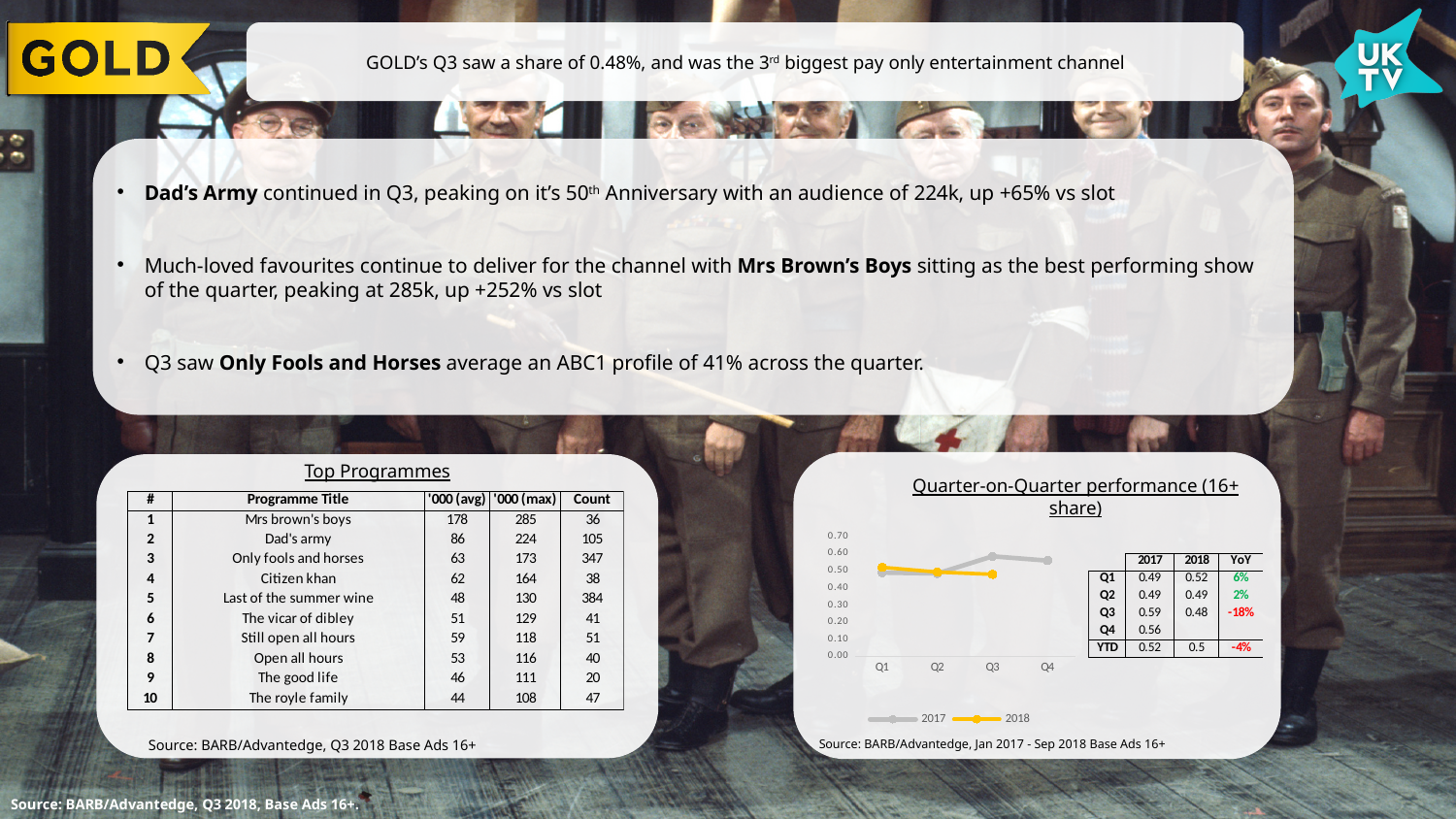
What kind of chart is the Quarter-on-Quarter performance (16+ share) chart? line chart In the Quarter-on-Quarter performance chart, does the 2018 series rise or fall from Q1 to Q3? fall According to the table beside the Quarter-on-Quarter performance chart, what is the YoY change for Q3? -18% In the Quarter-on-Quarter performance chart, which series has the higher value at Q3, 2017 or 2018? 2017 In the Quarter-on-Quarter performance chart, is the 2018 value for Q3 greater or less than 0.50? less According to the table beside the Quarter-on-Quarter performance chart, what was the 2017 share in Q3? 0.59 In the Quarter-on-Quarter performance chart, is the 2017 value for Q3 greater or less than 0.50? greater According to the table beside the Quarter-on-Quarter performance chart, what was the 2018 share in Q1? 0.52 How many series does the legend of the Quarter-on-Quarter performance chart list? 2 How many quarters are shown on the x axis of the Quarter-on-Quarter performance chart? 4 In the Quarter-on-Quarter performance chart, which quarter has the highest 2017 value? Q3 Which two series are listed in the legend of the Quarter-on-Quarter performance chart? 2017 and 2018